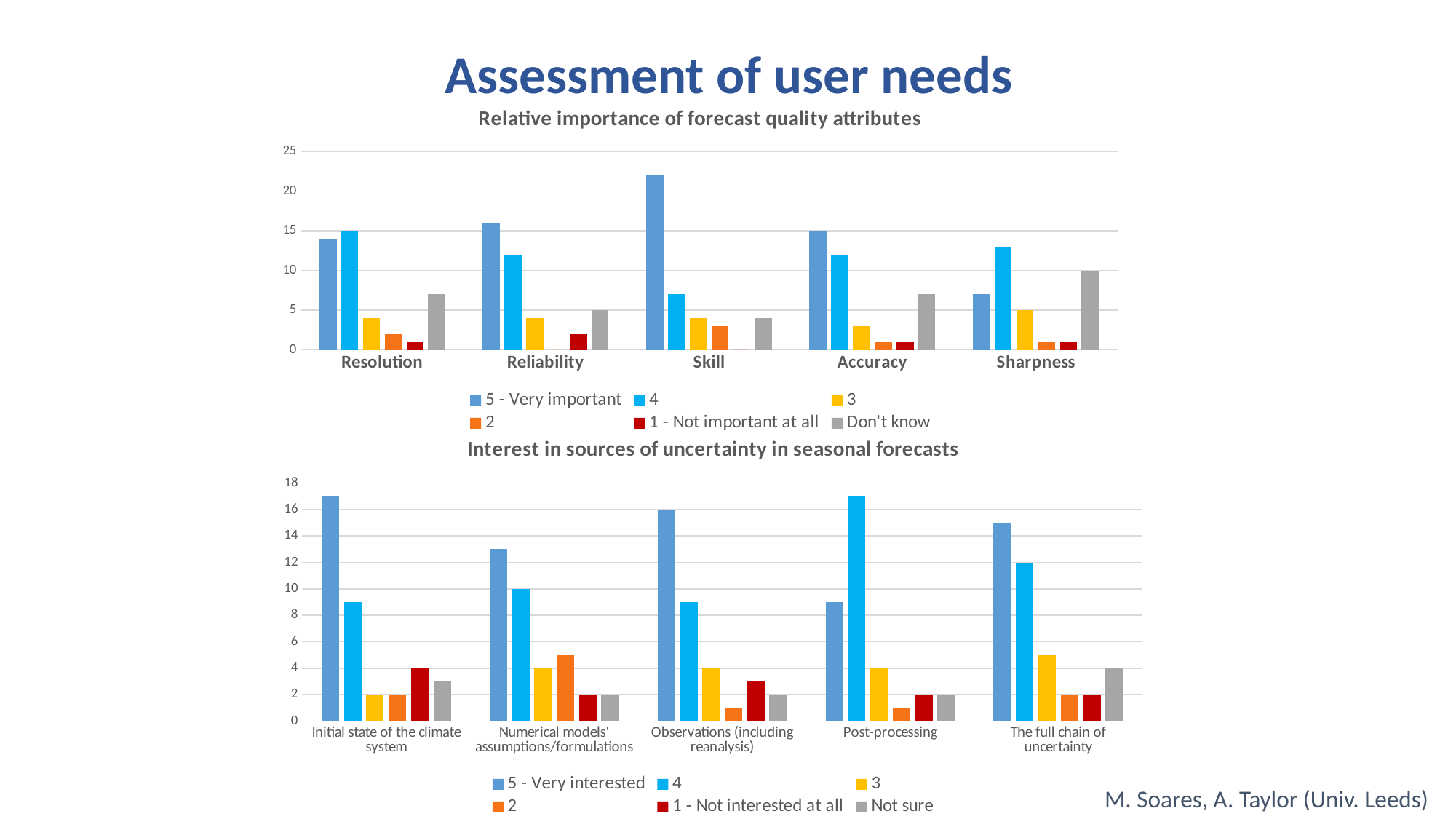
How many categories are shown on the x axis of the top chart (Relative importance of forecast quality attributes)? 5 How many series does the legend of the bottom chart (Interest in sources of uncertainty in seasonal forecasts) list? 6 In the bottom chart (Interest in sources of uncertainty in seasonal forecasts), is the '5 - Very interested' value for Initial state of the climate system greater or less than 14? greater What kind of chart is the bottom chart (Interest in sources of uncertainty in seasonal forecasts)? bar chart What is the title of the bottom chart on the slide? Interest in sources of uncertainty in seasonal forecasts In the top chart (Relative importance of forecast quality attributes), which category has the shortest '5 - Very important' bar? Sharpness In the top chart (Relative importance of forecast quality attributes), which is larger: the '4' value for Skill or the '4' value for Accuracy? Accuracy In the top chart (Relative importance of forecast quality attributes), which category has the tallest '5 - Very important' bar? Skill In the bottom chart (Interest in sources of uncertainty in seasonal forecasts), which category has the tallest '4' bar? Post-processing In the top chart (Relative importance of forecast quality attributes), is the '5 - Very important' value for Skill greater or less than 20? greater In the bottom chart (Interest in sources of uncertainty in seasonal forecasts), which is larger: the '5 - Very interested' value for Initial state of the climate system or for Numerical models' assumptions/formulations? Initial state of the climate system In the top chart (Relative importance of forecast quality attributes), which category has the tallest 'Don't know' bar? Sharpness